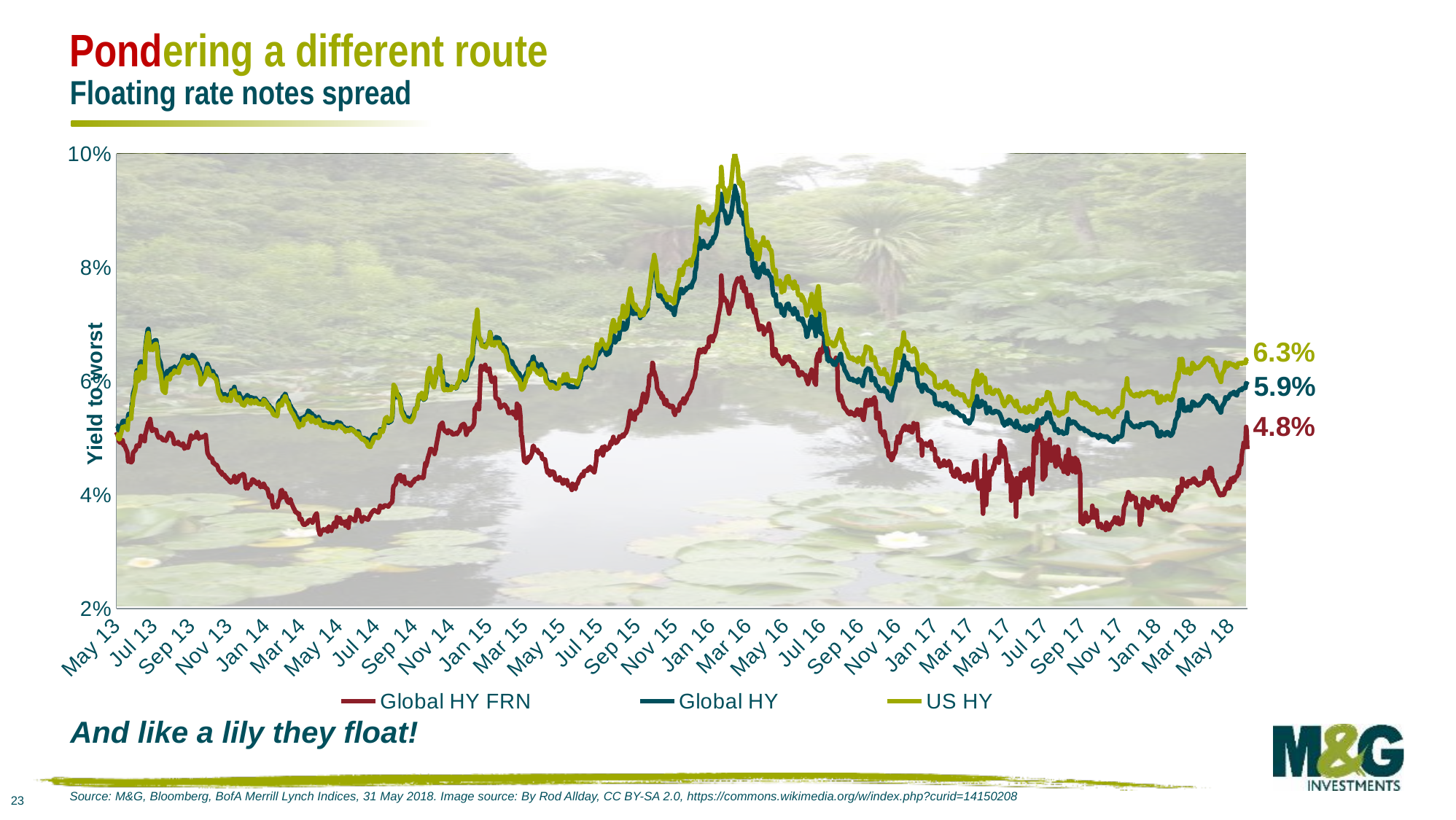
How many series does the legend list? 3 What is the difference between the final values of US HY and Global HY FRN? 1.5% What is the final value shown for the Global HY FRN series? 4.8% What is the final value shown for the US HY series? 6.3% At the end of the chart, which is larger: the Global HY value or the Global HY FRN value? Global HY What kind of chart is shown on the slide? Line chart What is the final value shown for the Global HY series? 5.9% What is the label on the vertical axis of the chart? Yield to worst Which series has the lowest value at the end of the chart? Global HY FRN What is the difference between the final values of Global HY and Global HY FRN? 1.1% Which series has the highest value at the end of the chart? US HY